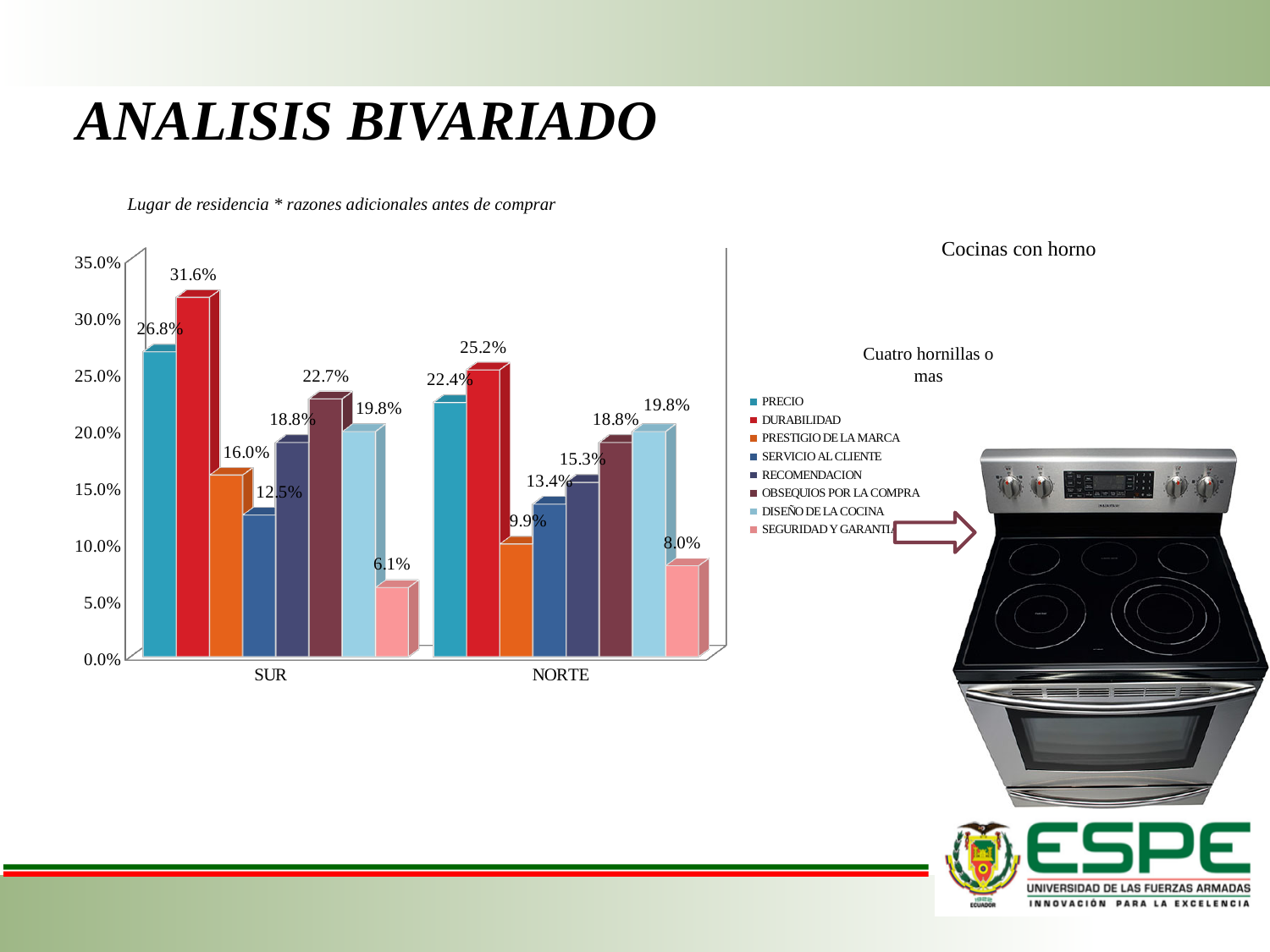
What is the value for DURABILIDAD in the SUR category? 31.6% What is the value for PRESTIGIO DE LA MARCA in the NORTE category? 9.9% Which series has the lowest value in the NORTE category? SEGURIDAD Y GARANTIA What is the value for PRECIO in the NORTE category? 22.4% What is the subtitle shown above the chart? Lugar de residencia * razones adicionales antes de comprar What is the difference between the DURABILIDAD values for SUR and NORTE? 6.4% What kind of chart is shown on the slide? Bar chart Which series has the highest value in the SUR category? DURABILIDAD Which is larger, the SERVICIO AL CLIENTE value for SUR or for NORTE? NORTE What is the value for SEGURIDAD Y GARANTIA in the SUR category? 6.1% How many categories are shown on the x axis? 2 How many series does the legend list? 8